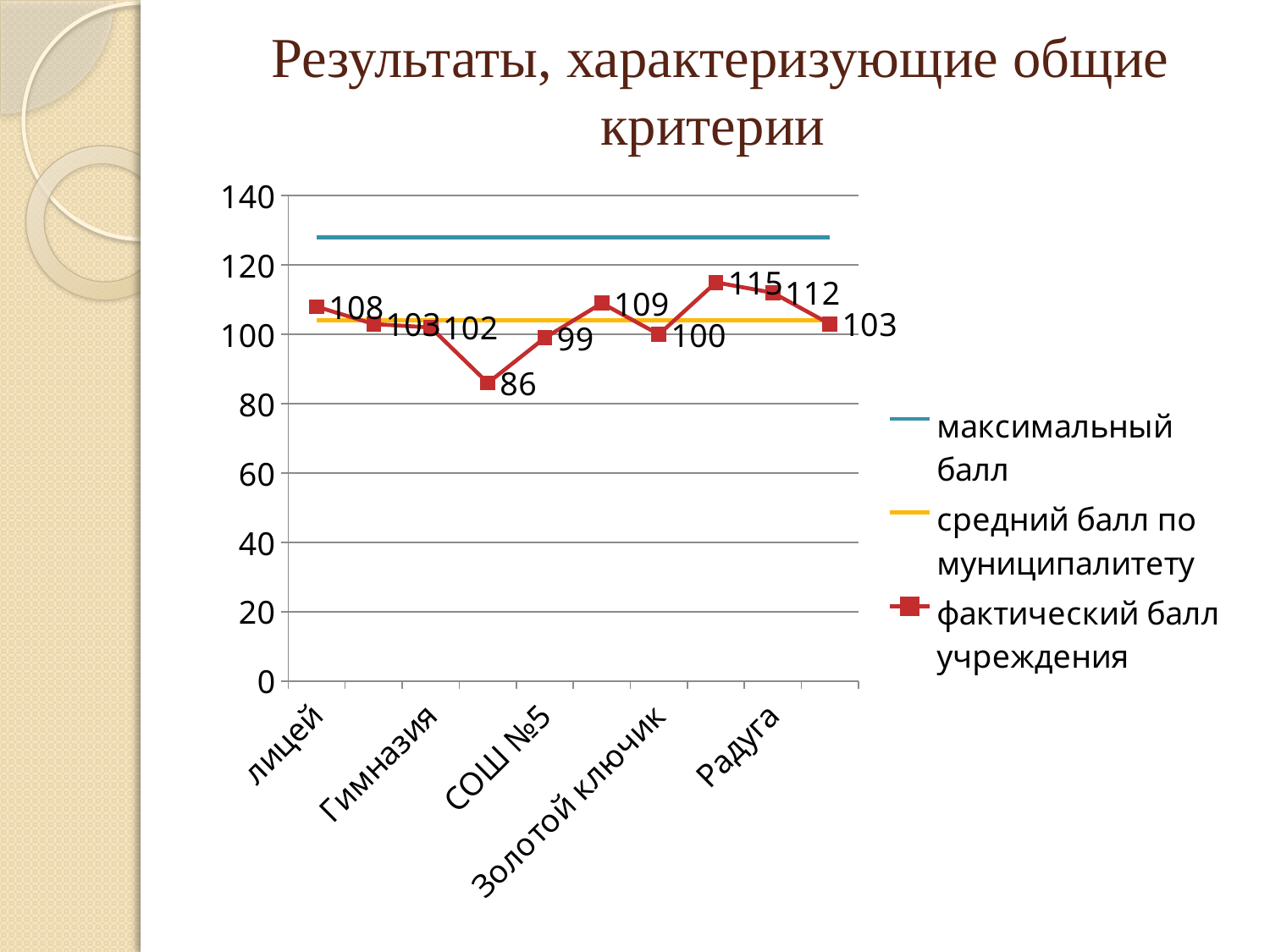
What kind of chart is shown on the slide? line chart What is the 'фактический балл учреждения' value for лицей? 108 Is the 'максимальный балл' line greater or less than 120? greater How many series does the legend list? 3 Which legend entry is drawn with square markers? фактический балл учреждения What is the 'фактический балл учреждения' value for Радуга? 112 Is the 'средний балл по муниципалитету' line greater or less than 120? less What is the difference between the highest (115) and lowest (86) values on the 'фактический балл учреждения' line? 29 What is the highest value labelled on the 'фактический балл учреждения' line? 115 Which has the larger 'фактический балл учреждения' value, лицей or Радуга? Радуга What is the lowest value labelled on the 'фактический балл учреждения' line? 86 How many data points are plotted on the 'фактический балл учреждения' line? 10